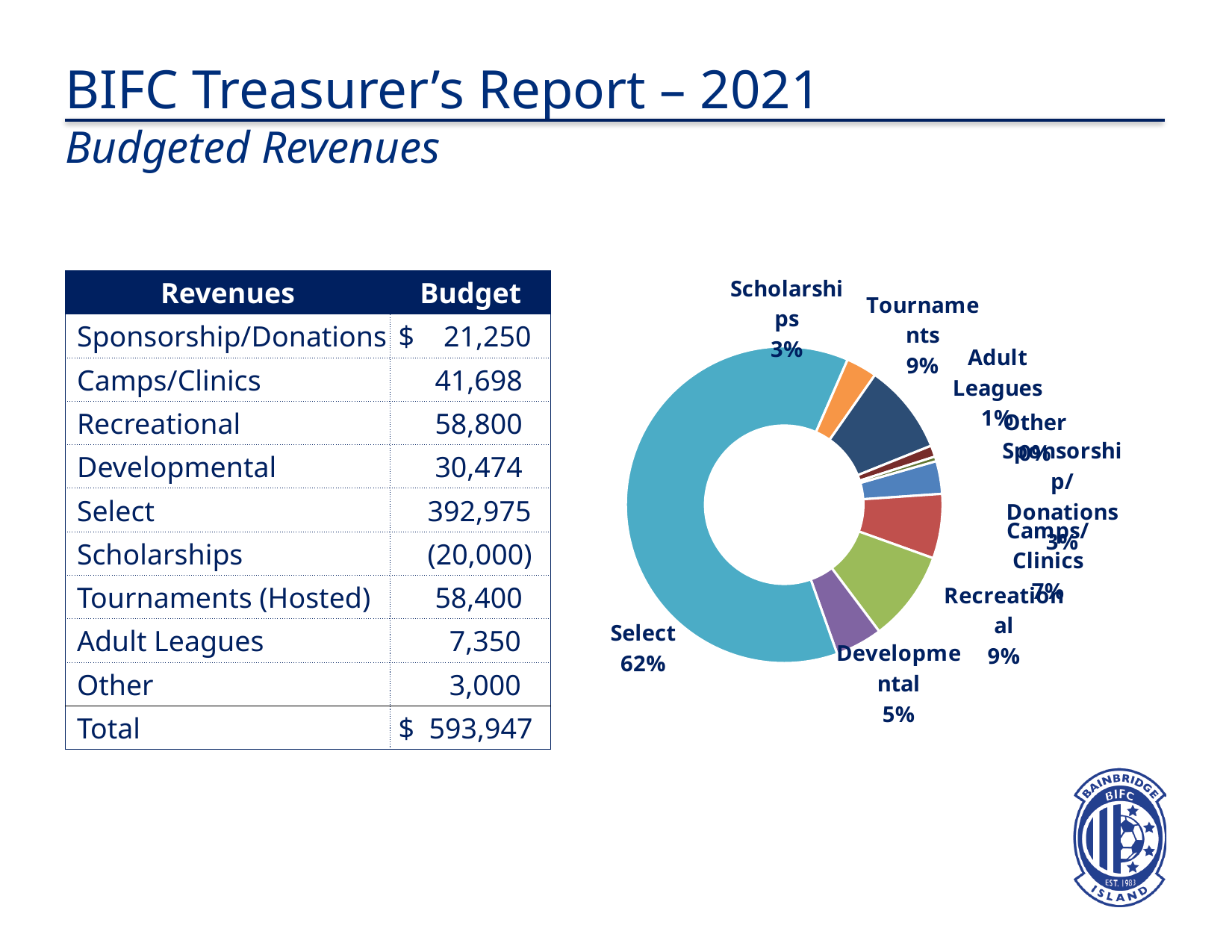
What percentage is shown for Adult Leagues in the chart? 1% What kind of chart is shown on the slide? Doughnut (pie) chart What is the difference in percentage points between the Select slice and the Tournaments slice? 53 What colour is the Select slice in the chart? Light blue (teal) What percentage is shown for Tournaments in the chart? 9% What percentage is shown for Developmental in the chart? 5% What share of budgeted revenues does the Select slice represent in the chart? 62% What percentage is shown for Recreational in the chart? 9% What percentage is shown for Scholarships in the chart? 3% Which category has the largest slice in the chart? Select Which is larger in the chart, the Developmental slice or the Tournaments slice? Tournaments How many categories are labelled in the chart? 9